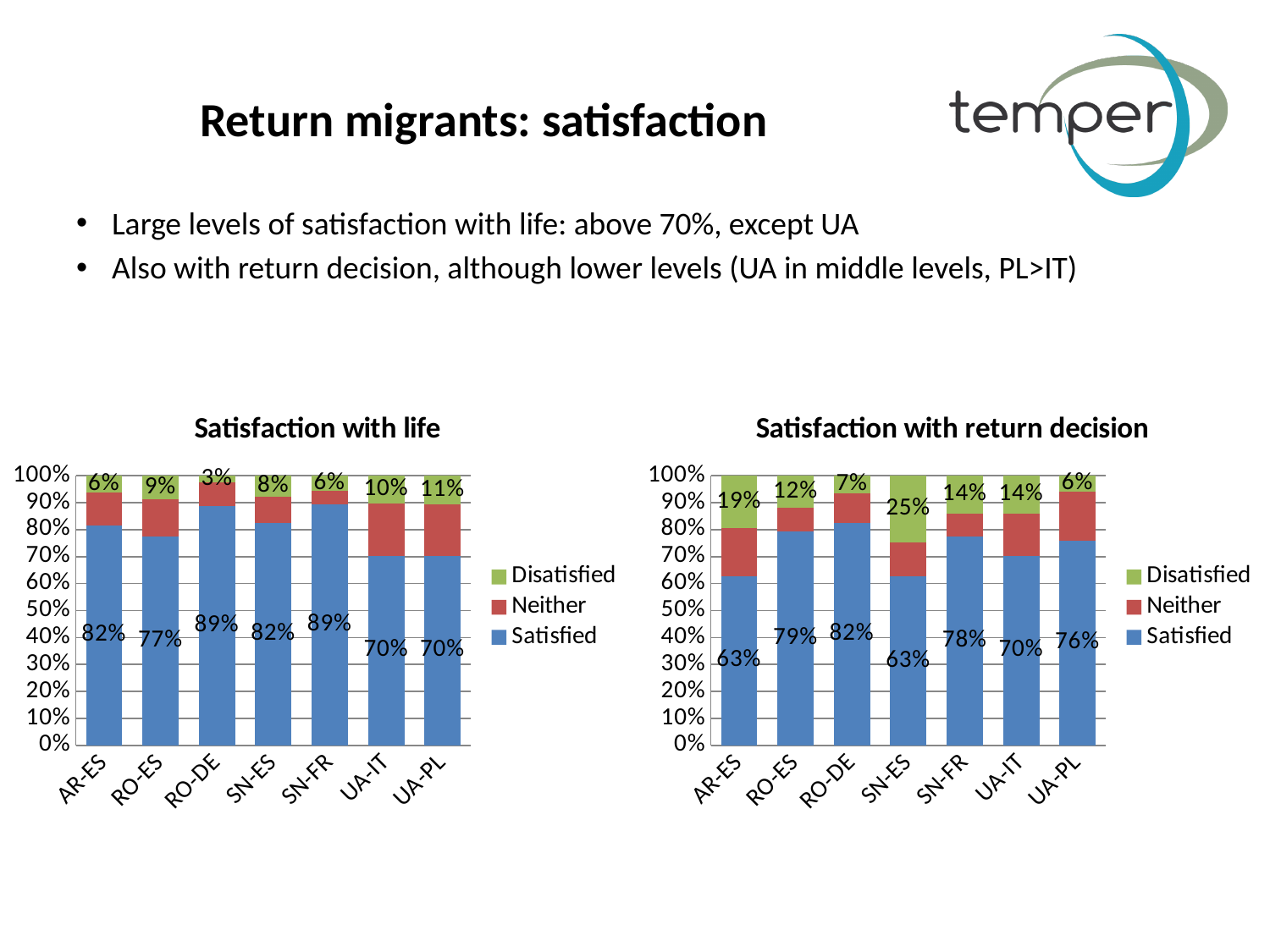
In the 'Satisfaction with life' chart, which category has the lowest Disatisfied value? RO-DE In the 'Satisfaction with return decision' chart, what is the Satisfied value for UA-PL? 76% In the 'Satisfaction with life' chart, what is the difference between the Satisfied values for RO-DE and UA-IT? 19% In the 'Satisfaction with return decision' chart, which category has the highest Disatisfied value? SN-ES In the 'Satisfaction with return decision' chart, which has a larger Satisfied value, RO-ES or SN-FR? RO-ES In the 'Satisfaction with return decision' chart, which category has the highest Satisfied value? RO-DE In the 'Satisfaction with life' chart, what is the Satisfied value for RO-ES? 77% What kind of chart is the 'Satisfaction with life' chart? Stacked bar chart How many series does the legend of the 'Satisfaction with return decision' chart list? 3 How many categories are shown on the x axis of the 'Satisfaction with life' chart? 7 In the 'Satisfaction with return decision' chart, what is the difference between the Disatisfied values for AR-ES and UA-PL? 13% In the 'Satisfaction with return decision' chart, what is the Disatisfied value for SN-ES? 25%